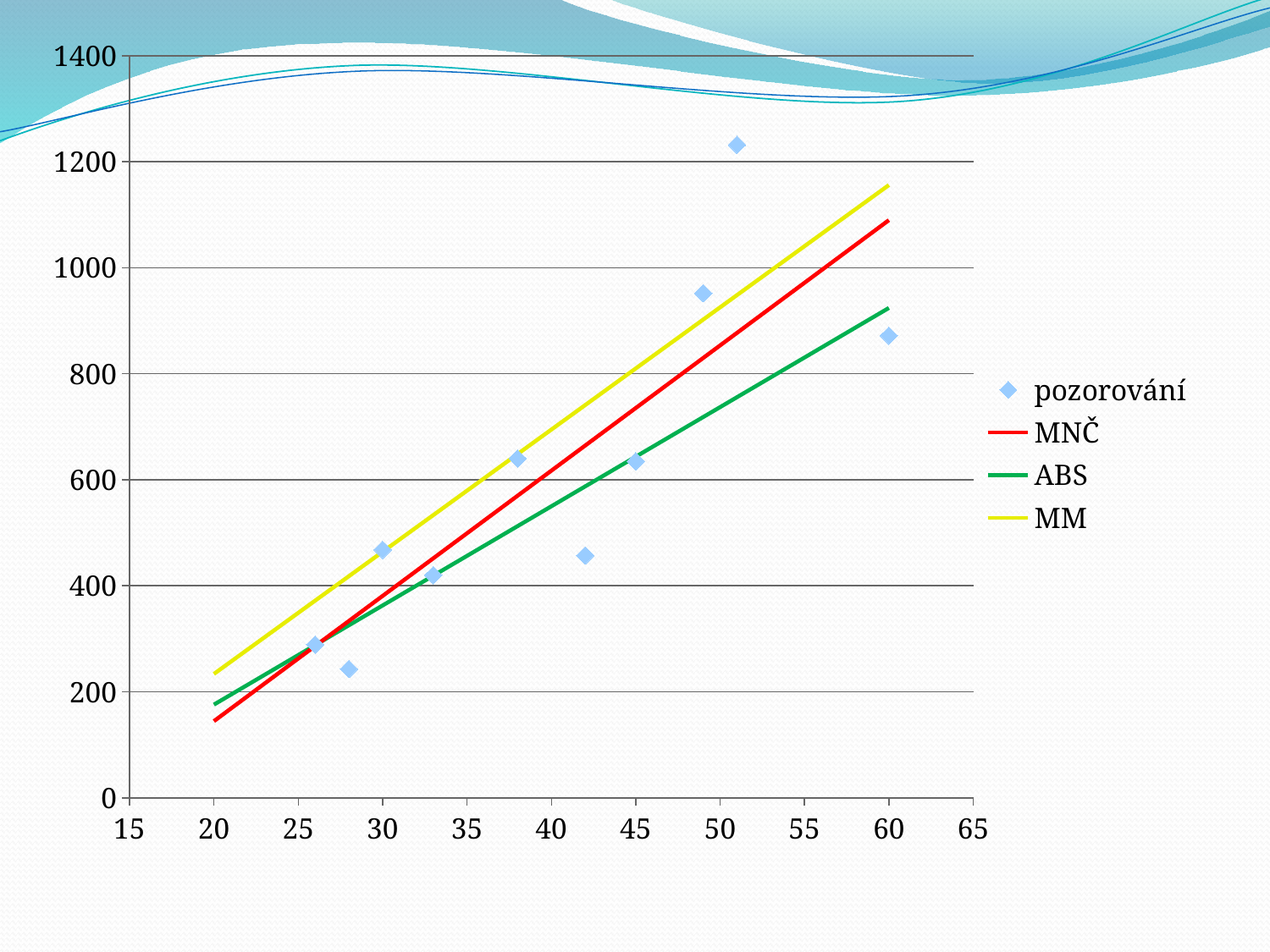
What kind of chart is shown on the slide? scatter chart with fitted lines Which fitted line has the lowest value at x = 60: MNČ, ABS or MM? ABS Do the observation values generally rise or fall as x increases? rise Is the observation value at x = 51 greater or less than 1200? greater At which x value is the lowest observation (pozorování) point? 28 How many observation points (pozorování) are plotted? 10 Is the observation value at x = 60 greater or less than 1000? less How many series does the legend list? 4 What colour is the MNČ line? red Is the observation value at x = 38 greater or less than 600? greater Which fitted line has the highest value at x = 60: MNČ, ABS or MM? MM At which x value is the highest observation (pozorování) point? 51